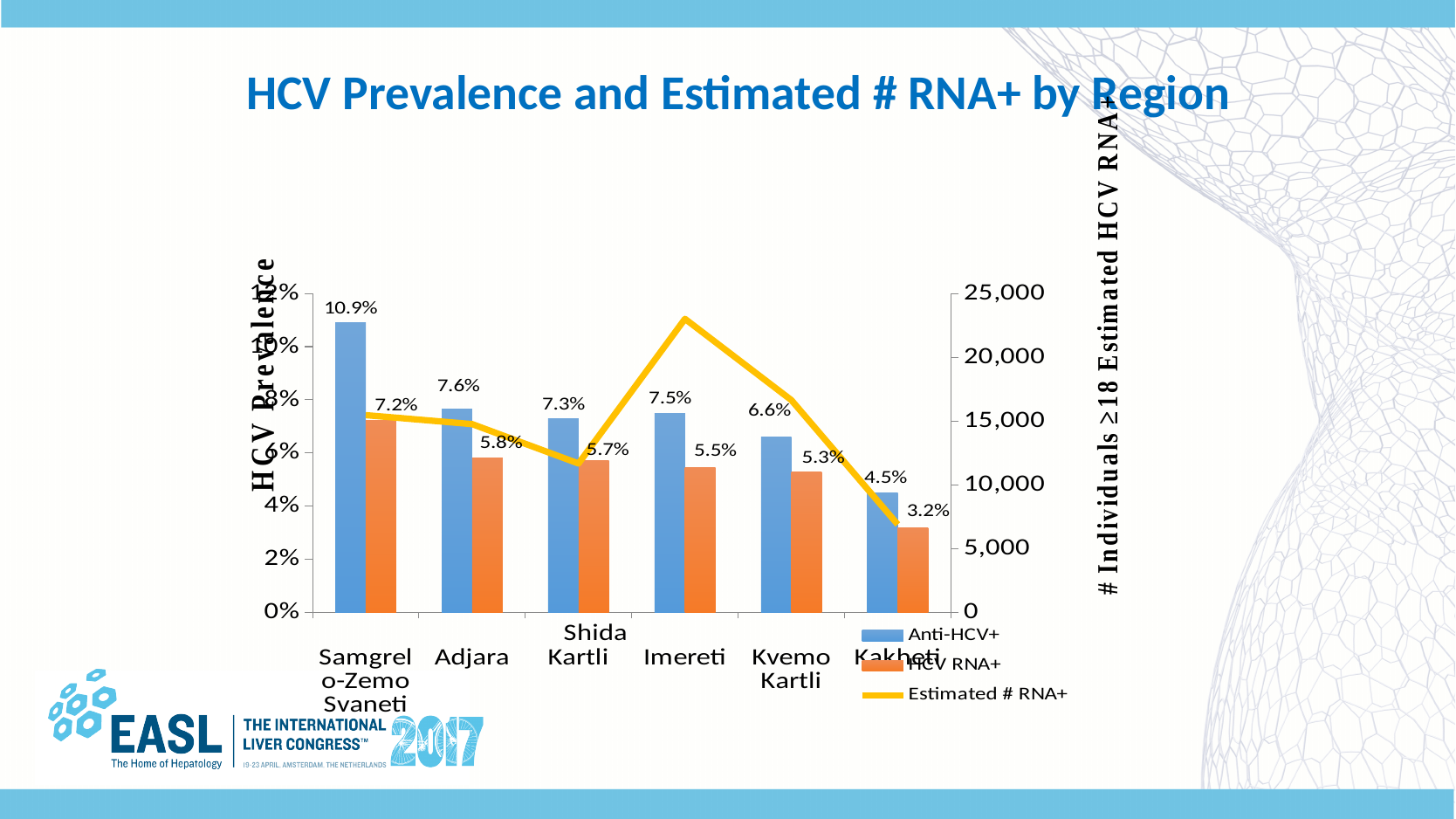
What is the difference between the Anti-HCV+ and HCV RNA+ prevalence in Imereti? 2.0% How many series does the legend list? 3 Which region has the lowest HCV RNA+ prevalence? Kakheti What is the HCV RNA+ prevalence for Kakheti? 3.2% Is the Estimated # RNA+ value for Kakheti greater or less than 10,000? less How many regions are shown on the x axis? 6 What is the HCV RNA+ prevalence for Adjara? 5.8% What is the Anti-HCV+ prevalence for Samgrelo-Zemo Svaneti? 10.9% What is the label of the right-hand vertical axis? # Individuals ≥18 Estimated HCV RNA+ Which is larger, the Anti-HCV+ prevalence in Adjara or in Kvemo Kartli? Adjara Which region has the highest Anti-HCV+ prevalence? Samgrelo-Zemo Svaneti Is the Estimated # RNA+ value for Imereti greater or less than 20,000? greater